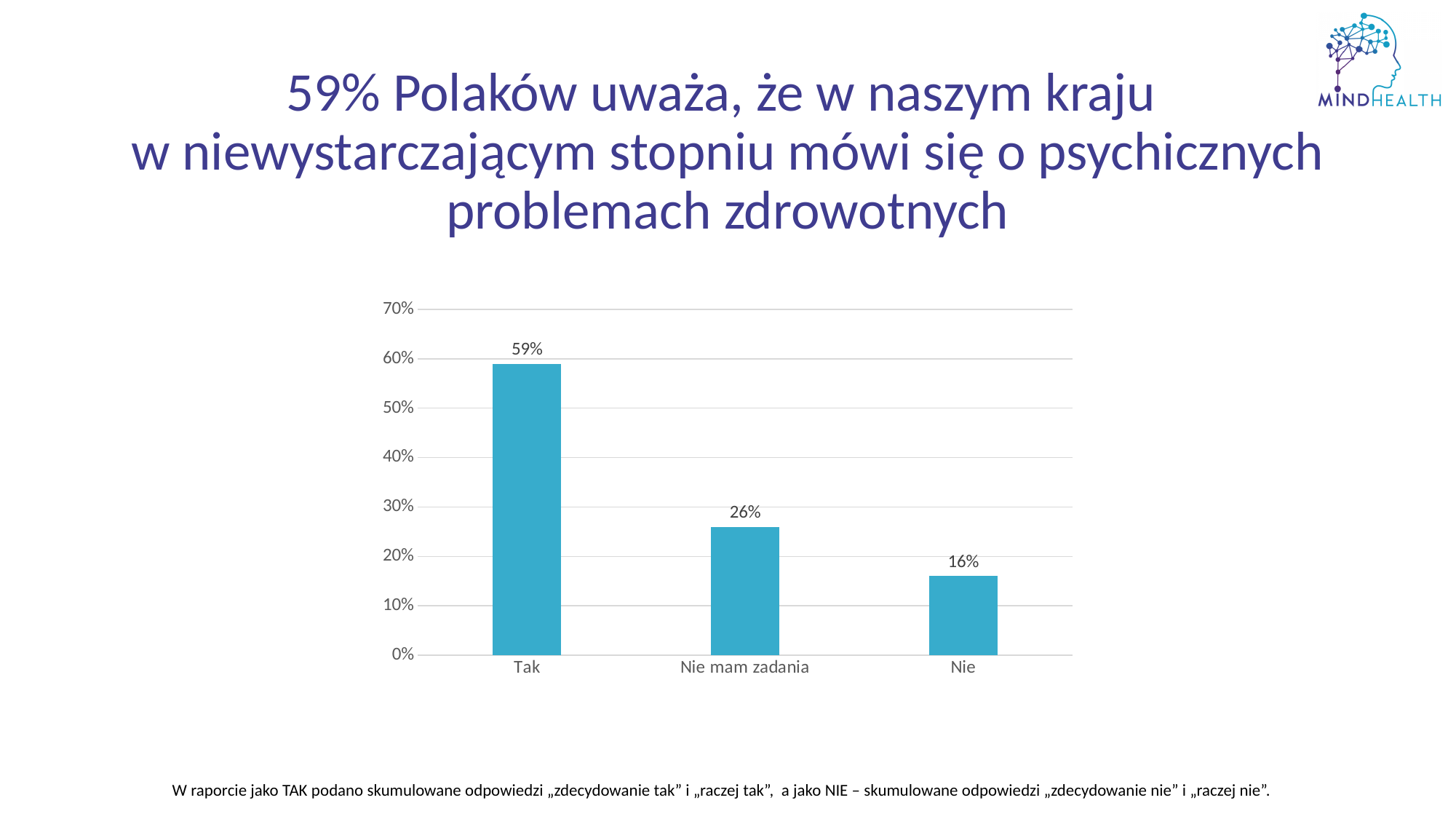
Which is larger, the value for Nie mam zadania or the value for Nie? Nie mam zadania What is the value for Tak? 59% What is the value for Nie mam zadania? 26% Do the values rise or fall from left to right along the x axis? fall What is the value for Nie? 16% What is the difference between the values for Nie mam zadania and Nie? 10% Which category has the lowest value? Nie Which category has the highest value? Tak How many categories are shown on the x axis? 3 What kind of chart is shown on the slide? bar chart Is the value for Tak greater or less than 50%? greater What is the difference between the values for Tak and Nie? 43%